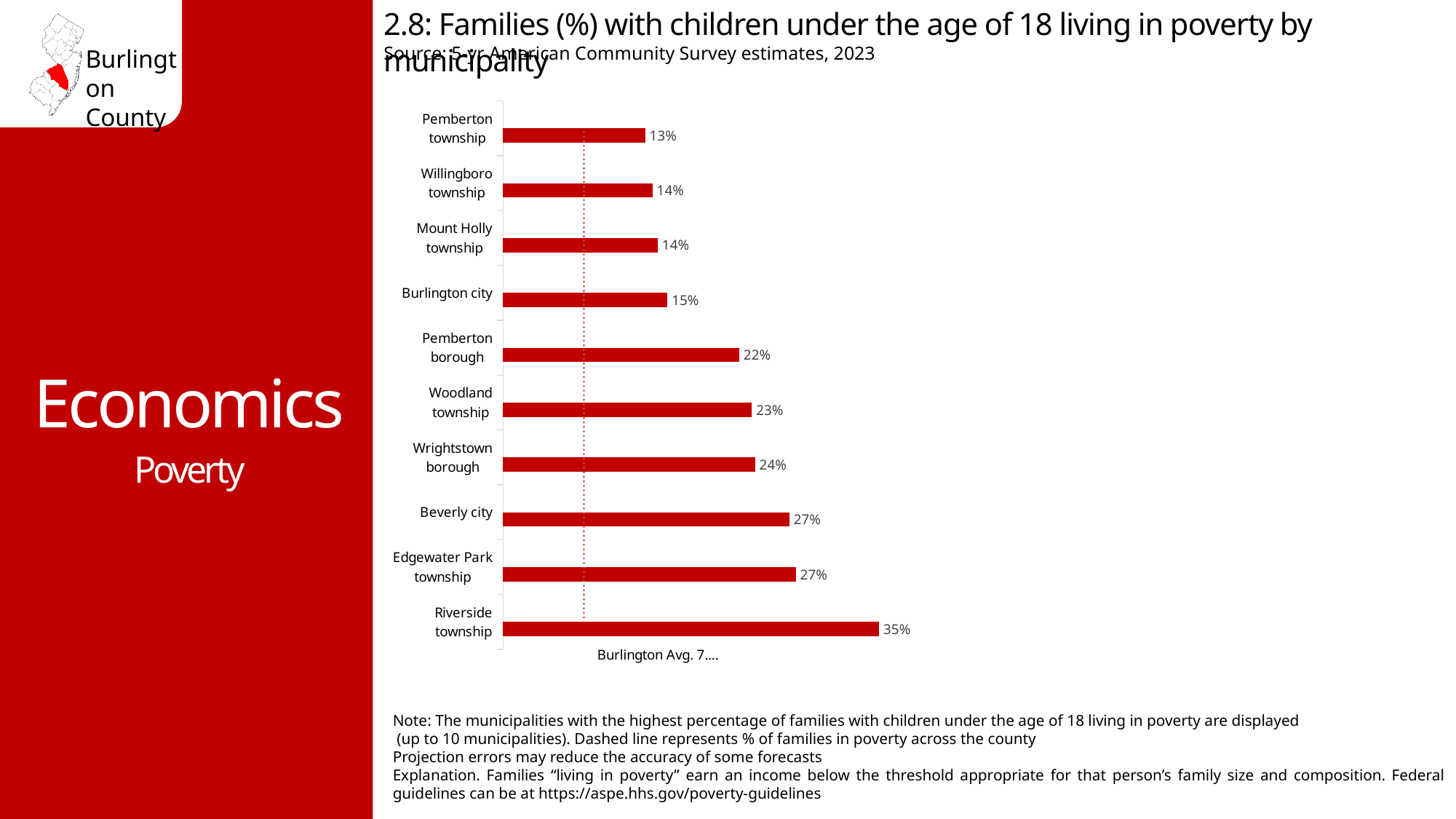
What is the difference between the values for Riverside township and Pemberton township? 22% What does the dashed vertical line on the chart represent? Burlington County average % of families in poverty What is the value shown for Burlington city? 15% What is the value shown for Pemberton borough? 22% What kind of chart is shown on the slide? Bar chart What is the difference between the values for Beverly city and Wrightstown borough? 3% How many municipalities are shown on the chart? 10 Do the values increase or decrease going from the top bar to the bottom bar? Increase Which municipality has the highest percentage of families with children under 18 living in poverty? Riverside township Which municipality has the lowest percentage shown on the chart? Pemberton township Which has a higher value, Woodland township or Willingboro township? Woodland township What percentage of families with children under 18 are living in poverty in Riverside township? 35%